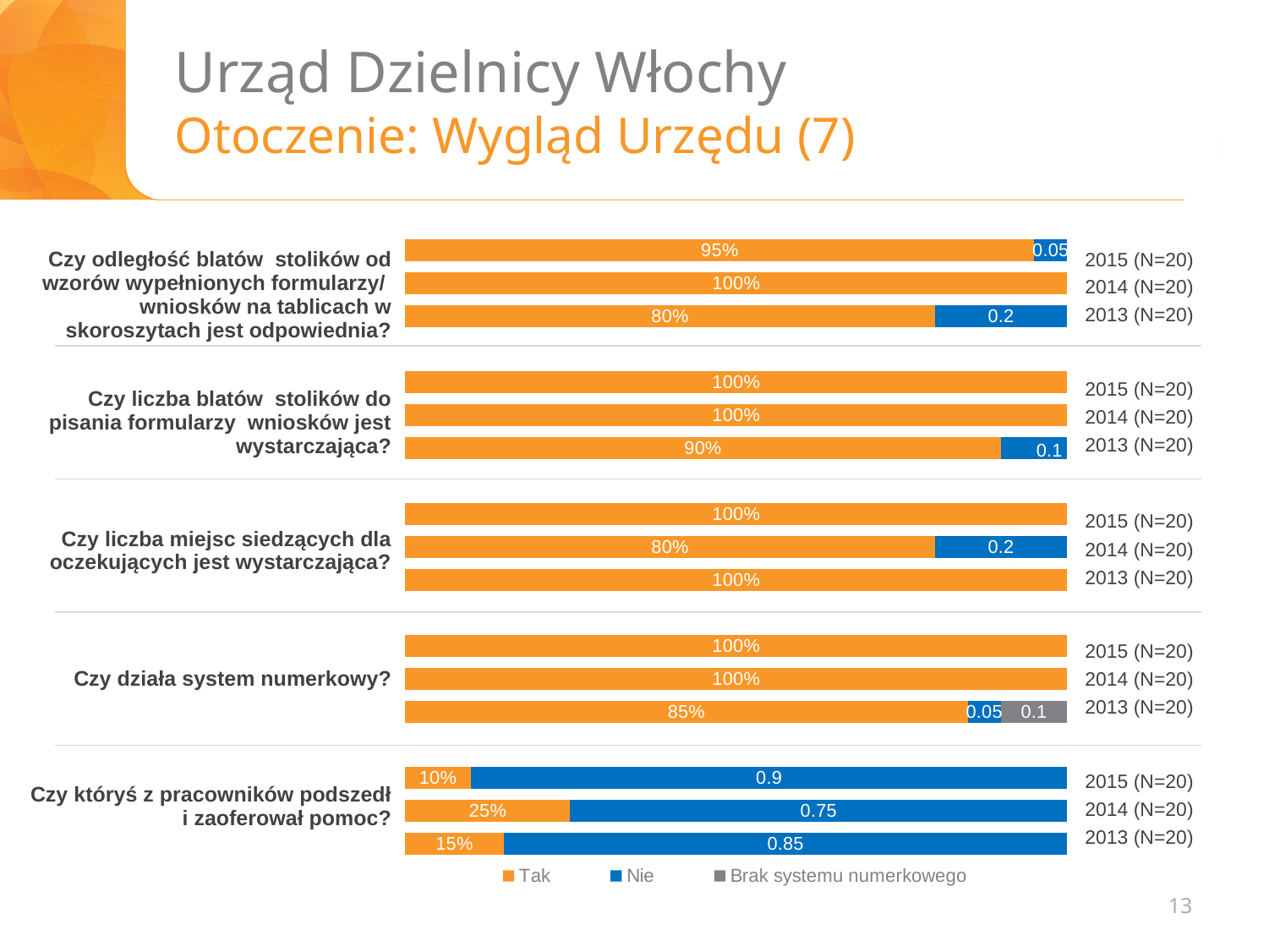
What is the "Tak" value for "Czy odległość blatów stolików od wzorów wypełnionych formularzy/wniosków na tablicach w skoroszytach jest odpowiednia?" in 2015 (N=20)? 95% What kind of chart is shown on the slide? Stacked bar chart What is the "Brak systemu numerkowego" value for "Czy działa system numerkowy?" in 2013 (N=20)? 0.1 What is the "Nie" value for "Czy któryś z pracowników podszedł i zaoferował pomoc?" in 2015 (N=20)? 0.9 What is the "Tak" value for "Czy działa system numerkowy?" in 2013 (N=20)? 85% For "Czy któryś z pracowników podszedł i zaoferował pomoc?", what is the difference between the "Nie" values in 2015 (N=20) and 2013 (N=20)? 0.05 What are the legend entries of the chart? Tak, Nie, Brak systemu numerkowego How many series does the legend list? 3 For "Czy któryś z pracowników podszedł i zaoferował pomoc?", which year has the highest "Tak" value? 2014 (N=20) For "Czy któryś z pracowników podszedł i zaoferował pomoc?", is the "Tak" value larger in 2014 (N=20) or 2013 (N=20)? 2014 (N=20) What is the "Tak" value for "Czy liczba miejsc siedzących dla oczekujących jest wystarczająca?" in 2014 (N=20)? 80% For "Czy odległość blatów stolików od wzorów wypełnionych formularzy/wniosków na tablicach w skoroszytach jest odpowiednia?", which year has the lowest "Tak" value? 2013 (N=20)